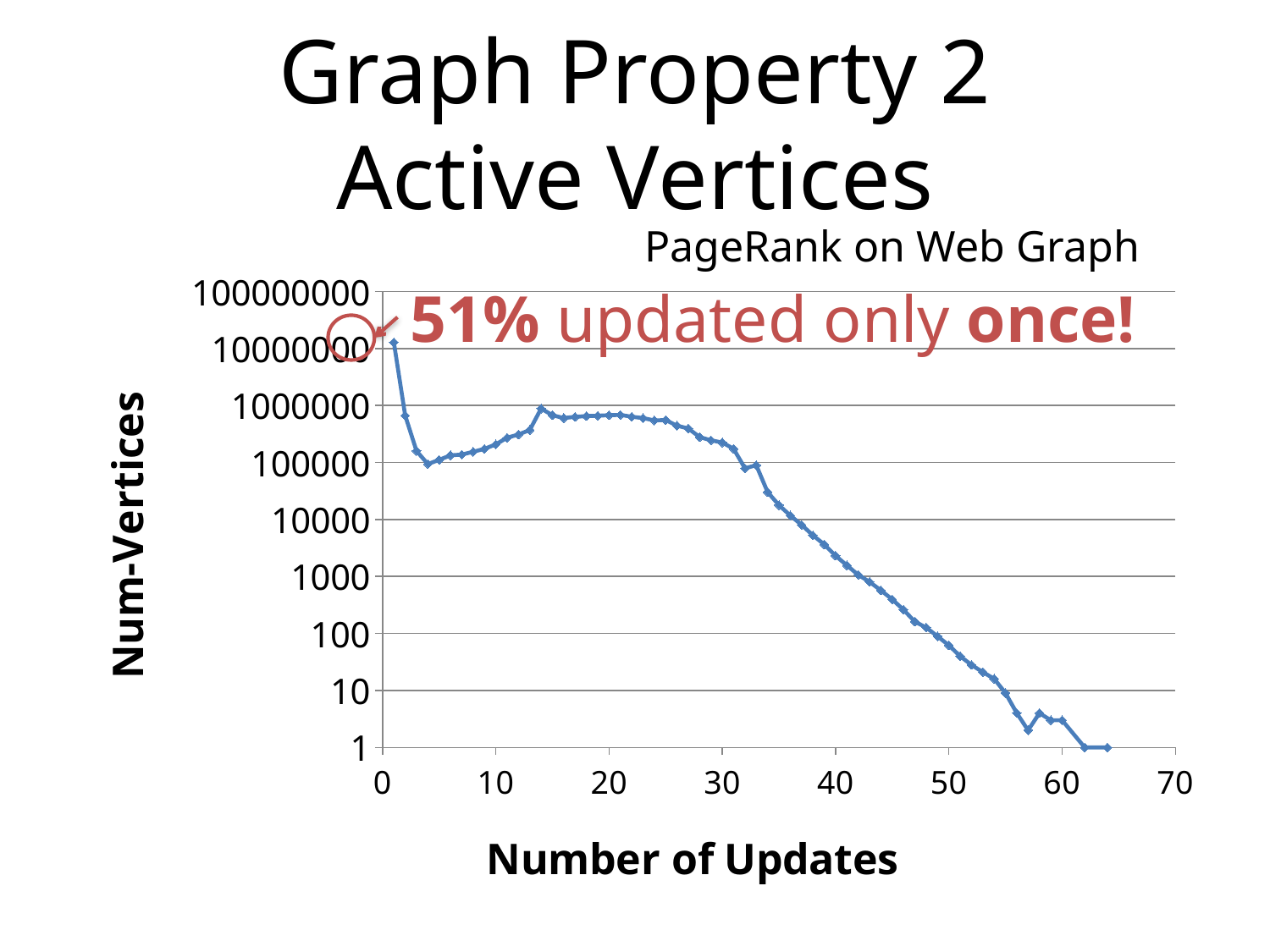
What is the number of vertices at 64 updates? 1 Which has more vertices: 1 update or 14 updates? 1 update What is the label of the y-axis of the chart? Num-Vertices What kind of chart is shown on the slide? line chart Do the values rise or fall as the number of updates increases from 30 to 64? fall Is the number of vertices at 20 updates greater or less than 100000? greater Which has more vertices: 20 updates or 40 updates? 20 updates Is the number of vertices at 60 updates greater or less than 10? less Is the number of vertices at 4 updates greater or less than 1000000? less What is the title of the chart? PageRank on Web Graph At which number of updates is the number of vertices highest? 1